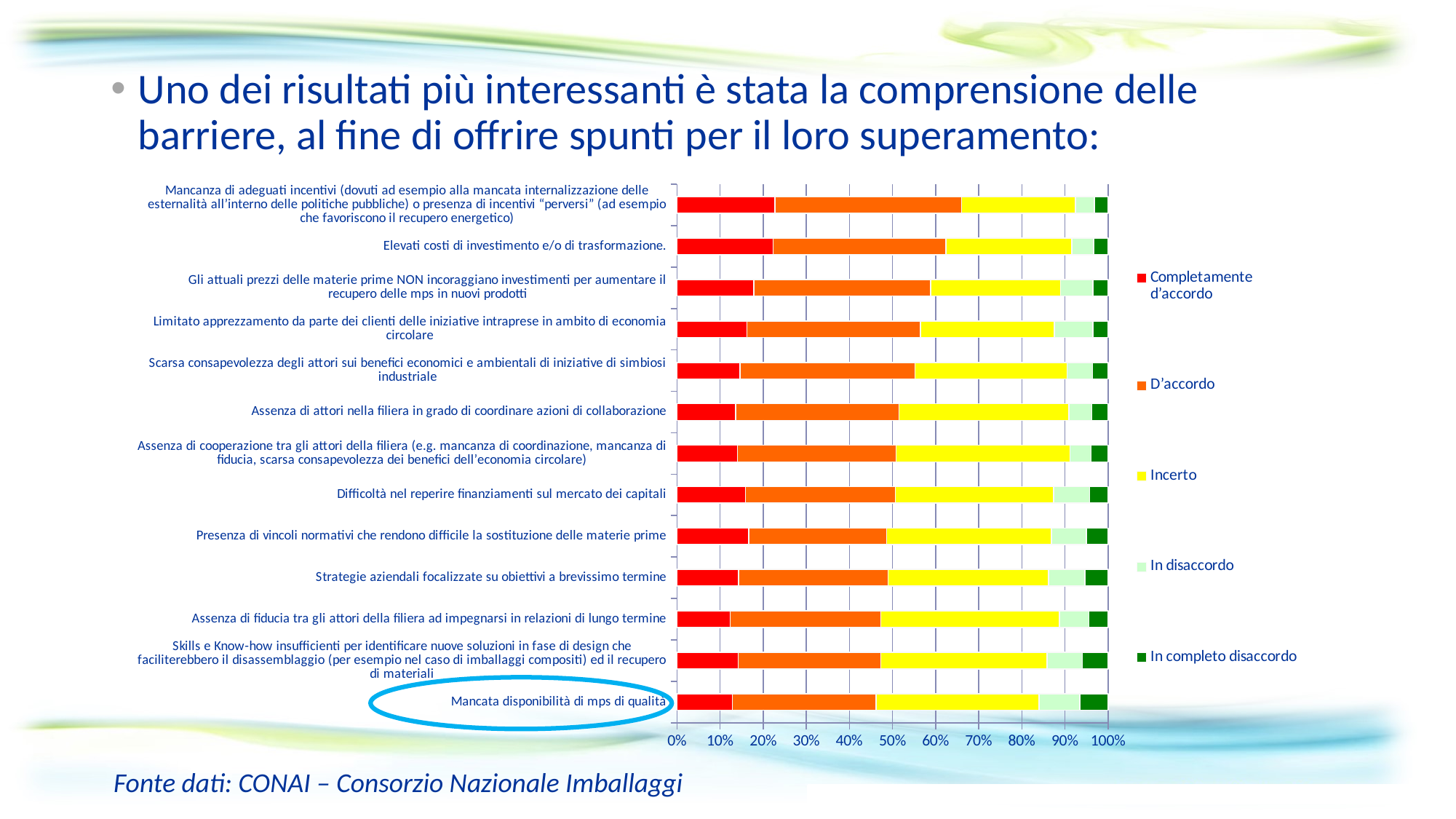
Is the combined 'Completamente d'accordo' plus 'D'accordo' share for 'Mancata disponibilità di mps di qualità' greater or less than 50%? less Is the 'Completamente d'accordo' value for 'Assenza di fiducia tra gli attori della filiera ad impegnarsi in relazioni di lungo termine' greater or less than 20%? less Which category label is circled on the chart? Mancata disponibilità di mps di qualità How many barrier categories are plotted in the chart? 13 Which has the larger 'Completamente d'accordo' segment: 'Elevati costi di investimento e/o di trasformazione' or 'Mancata disponibilità di mps di qualità'? Elevati costi di investimento e/o di trasformazione Is the 'Completamente d'accordo' value for 'Mancata disponibilità di mps di qualità' greater or less than 20%? less What is the first entry in the chart legend? Completamente d'accordo How many series does the chart legend list? 5 Going from the top category to the bottom category, do the 'Completamente d'accordo' segments generally get larger or smaller? smaller What is the maximum value shown on the horizontal axis of the chart? 100% What kind of chart is shown on the slide? Stacked bar chart